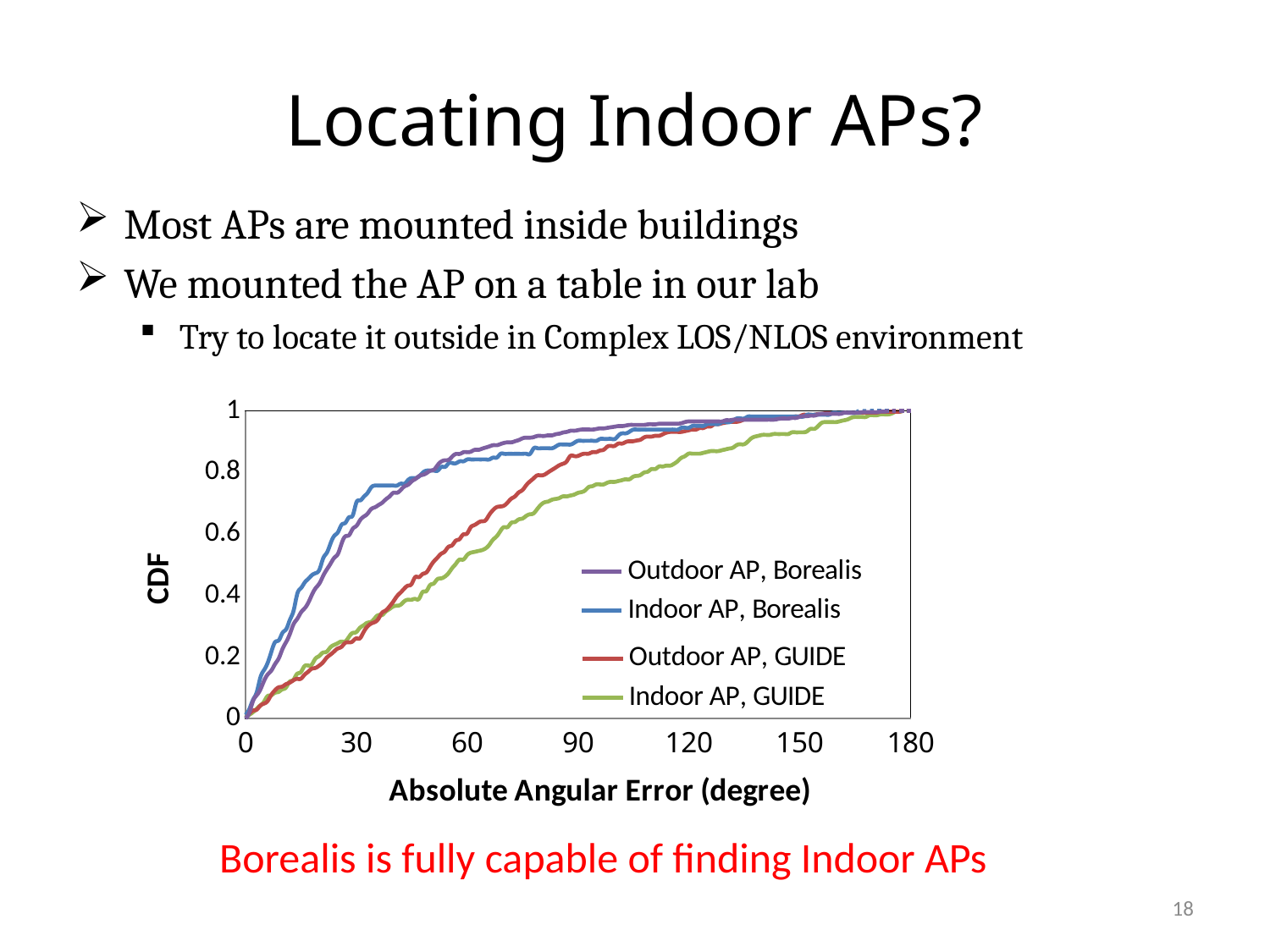
At 60 degrees of absolute angular error, which series has the higher CDF: Indoor AP, Borealis or Indoor AP, GUIDE? Indoor AP, Borealis Do the CDF curves rise or fall as absolute angular error increases along the x axis? rise What is the label of the y axis? CDF At 120 degrees of absolute angular error, which series has the higher CDF: Outdoor AP, GUIDE or Indoor AP, GUIDE? Outdoor AP, GUIDE Is the CDF value for Indoor AP, Borealis at 30 degrees greater or less than 0.4? greater What is the label of the x axis? Absolute Angular Error (degree) At 90 degrees of absolute angular error, which series has the lowest CDF? Indoor AP, GUIDE How many series does the legend list? 4 What kind of chart is shown on the slide? line chart What is the maximum value shown on the x axis? 180 Is the CDF value for Indoor AP, GUIDE at 30 degrees greater or less than 0.4? less Is the CDF value for Outdoor AP, GUIDE at 60 degrees greater or less than 0.8? less